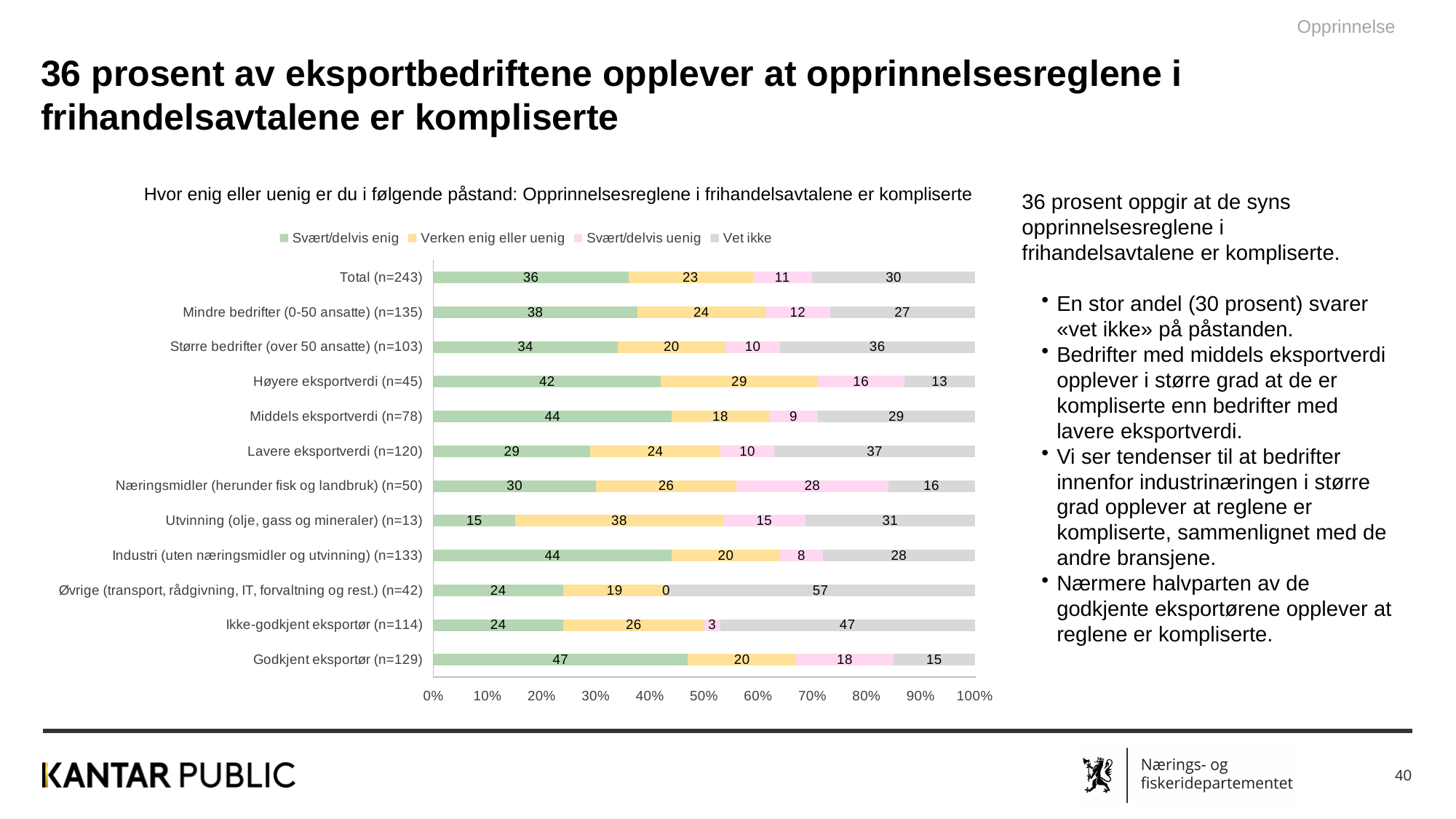
Which legend entry is shown in green? Svært/delvis enig How many series does the legend list? 4 Which category has the lowest value for Vet ikke? Høyere eksportverdi (n=45) What is the value of Svært/delvis uenig for Næringsmidler (herunder fisk og landbruk) (n=50)? 28 Which is larger: Verken enig eller uenig for Utvinning (olje, gass og mineraler) (n=13) or for Industri (uten næringsmidler og utvinning) (n=133)? Utvinning (olje, gass og mineraler) (n=13) Which category has the highest value for Svært/delvis enig? Godkjent eksportør (n=129) What is the value of Vet ikke for Øvrige (transport, rådgivning, IT, forvaltning og rest.) (n=42)? 57 What is the value of Svært/delvis enig for Total (n=243)? 36 What kind of chart is shown on the slide? Stacked bar chart What is the difference in Svært/delvis enig between Middels eksportverdi (n=78) and Lavere eksportverdi (n=120)? 15 Which category has the lowest value for Svært/delvis enig? Utvinning (olje, gass og mineraler) (n=13) How many categories are plotted on the chart? 12